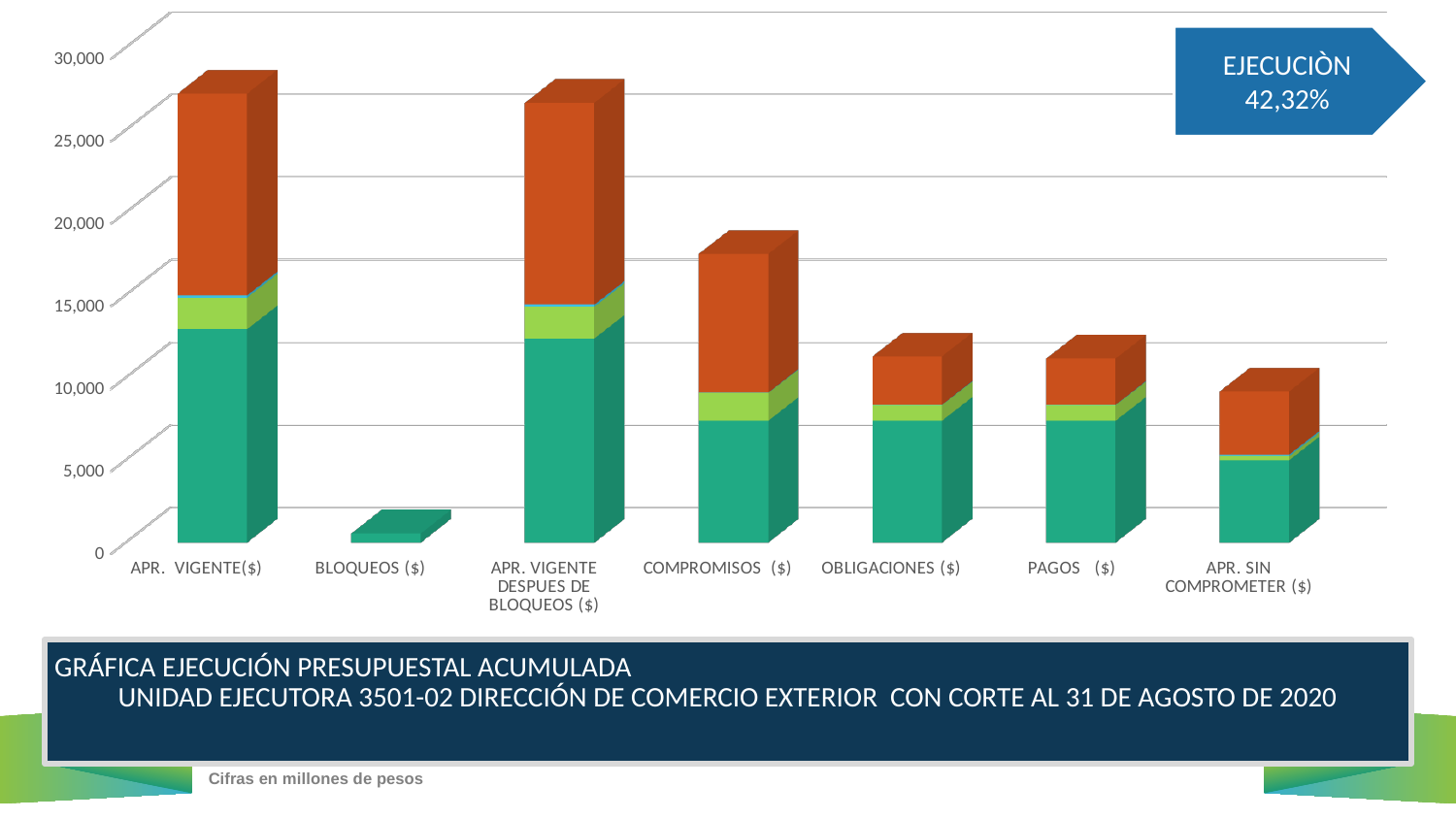
Which bar is taller, APR. VIGENTE DESPUES DE BLOQUEOS ($) or COMPROMISOS ($)? APR. VIGENTE DESPUES DE BLOQUEOS ($) Is the total value for APR. VIGENTE($) greater or less than 25,000? greater Which bar is taller, COMPROMISOS ($) or OBLIGACIONES ($)? COMPROMISOS ($) How many categories are shown along the x axis of the chart? 7 Is the total value for APR. SIN COMPROMETER ($) greater or less than 10,000? less Is the total value for COMPROMISOS ($) greater or less than 15,000? greater What execution percentage (EJECUCIÒN) is shown in the callout on the slide? 42,32% Which category has the lowest bar in the chart? BLOQUEOS ($) From COMPROMISOS ($) through APR. SIN COMPROMETER ($), do the bar totals rise or fall along the x axis? fall What kind of chart is shown on the slide? Stacked bar chart